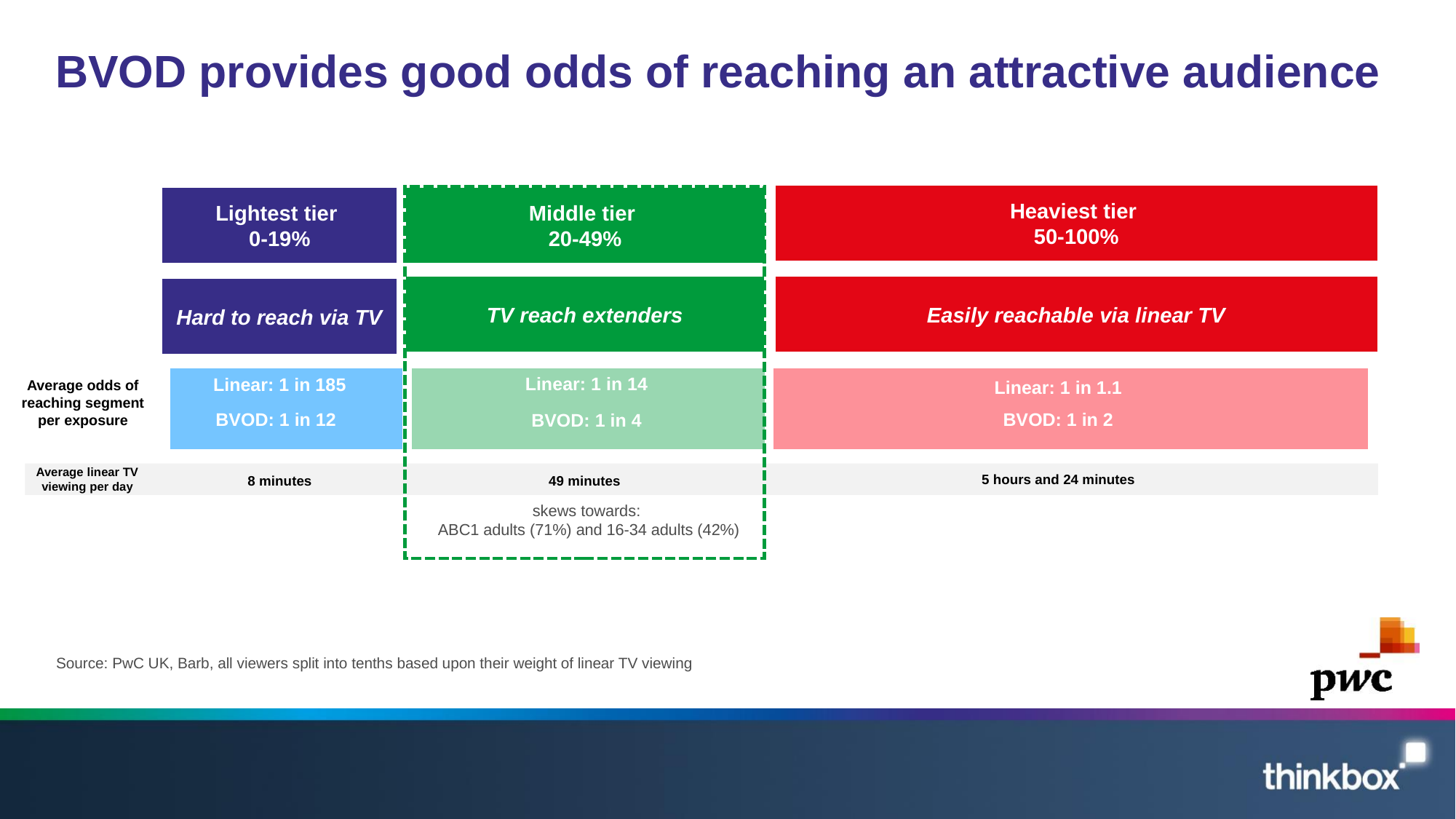
What are the average odds of reaching the lightest tier segment per exposure via BVOD? 1 in 12 What are the average odds of reaching the middle tier segment per exposure via linear TV? 1 in 14 What are the average odds of reaching the lightest tier segment per exposure via linear TV? 1 in 185 What are the average odds of reaching the heaviest tier segment per exposure via BVOD? 1 in 2 What is the average linear TV viewing per day for the lightest tier? 8 minutes What percentage range of linear TV viewing defines the middle tier? 20-49% What is the average linear TV viewing per day for the heaviest tier? 5 hours and 24 minutes What are the average odds of reaching the heaviest tier segment per exposure via linear TV? 1 in 1.1 How many tiers of linear TV viewing are shown on the slide? 3 Which tier is described as 'Hard to reach via TV'? Lightest tier What are the average odds of reaching the middle tier segment per exposure via BVOD? 1 in 4 What is the average linear TV viewing per day for the middle tier? 49 minutes